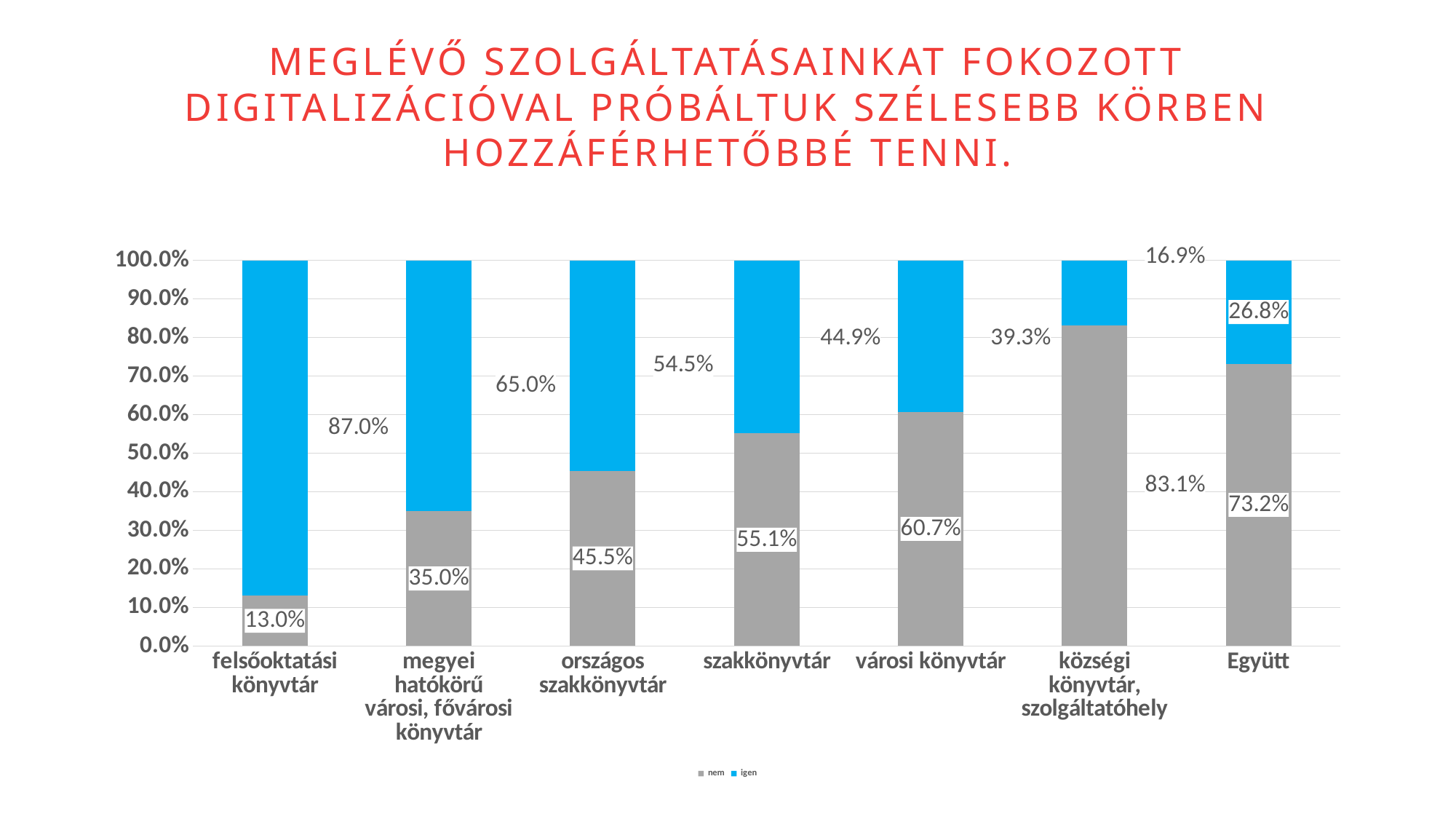
How many categories are shown on the x axis? 7 What kind of chart is shown on the slide? stacked bar chart What is the "nem" value for felsőoktatási könyvtár? 13.0% What is the "nem" value for városi könyvtár? 60.7% What is the "igen" value for községi könyvtár, szolgáltatóhely? 16.9% How many series does the legend list? 2 What is the difference between the "nem" values for szakkönyvtár and országos szakkönyvtár? 9.6% Which category has the lowest "nem" value? felsőoktatási könyvtár Which category has the highest "igen" value? felsőoktatási könyvtár What is the "nem" value for Együtt? 73.2% What is the "igen" value for megyei hatókörű városi, fővárosi könyvtár? 65.0% Which is larger: the "igen" value for szakkönyvtár or for városi könyvtár? szakkönyvtár